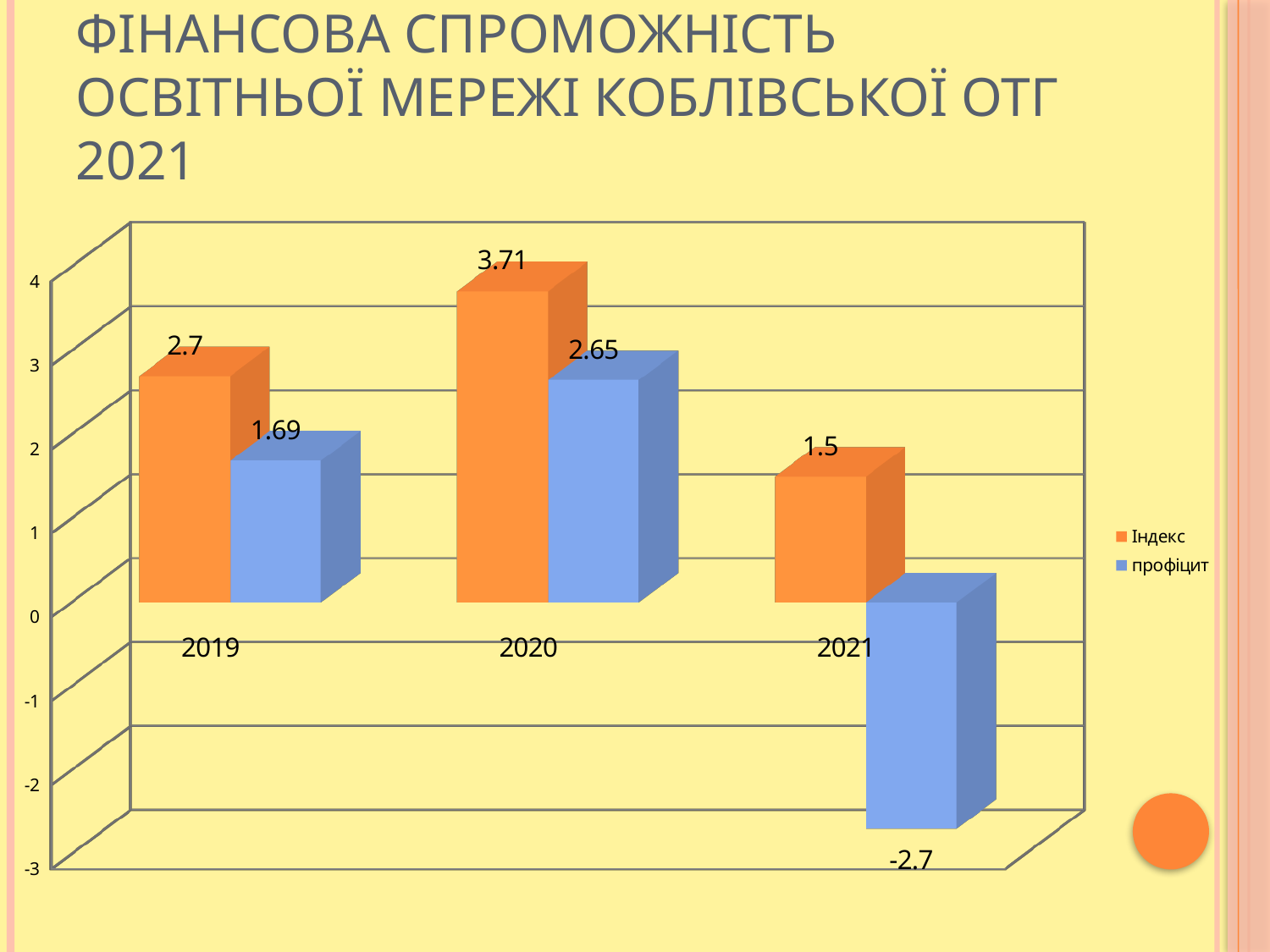
How many years are shown on the x axis? 3 How many series does the legend list? 2 Which is larger in 2020, Індекс or профіцит? Індекс What is the difference between Індекс and профіцит in 2019? 1.01 What is the value of Індекс for 2021? 1.5 What is the value of профіцит for 2021? -2.7 In which year is Індекс highest? 2020 In which year is профіцит lowest? 2021 What kind of chart is shown on the slide? Bar chart What is the value of профіцит for 2019? 1.69 What is the difference between Індекс in 2020 and Індекс in 2021? 2.21 What is the value of Індекс for 2020? 3.71